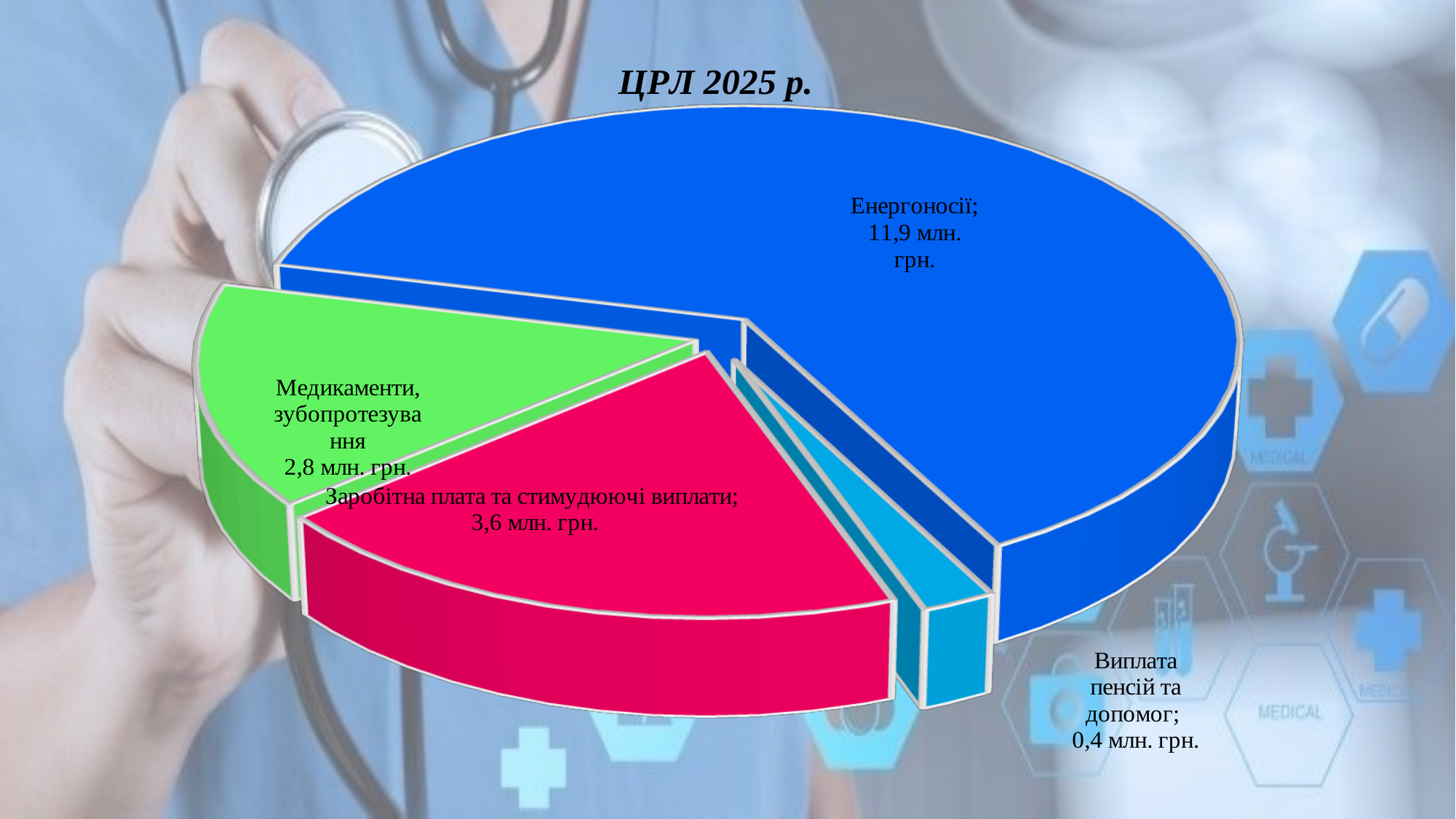
What is the title of the chart? ЦРЛ 2025 р. Which category has the smallest slice of the pie? Виплата пенсій та допомог Which is larger: Заробітна плата та стимудюючі виплати or Медикаменти, зубопротезування? Заробітна плата та стимудюючі виплати What is the value for Медикаменти, зубопротезування? 2,8 млн. грн. What is the difference between the values for Енергоносії and Заробітна плата та стимудюючі виплати? 8,3 млн. грн. What is the value for Енергоносії? 11,9 млн. грн. What is the value for Виплата пенсій та допомог? 0,4 млн. грн. Which category has the largest slice of the pie? Енергоносії What colour is the slice for Енергоносії? Blue How many slices does the pie chart have? 4 What is the value for Заробітна плата та стимудюючі виплати? 3,6 млн. грн. What kind of chart is shown on the slide? Pie chart